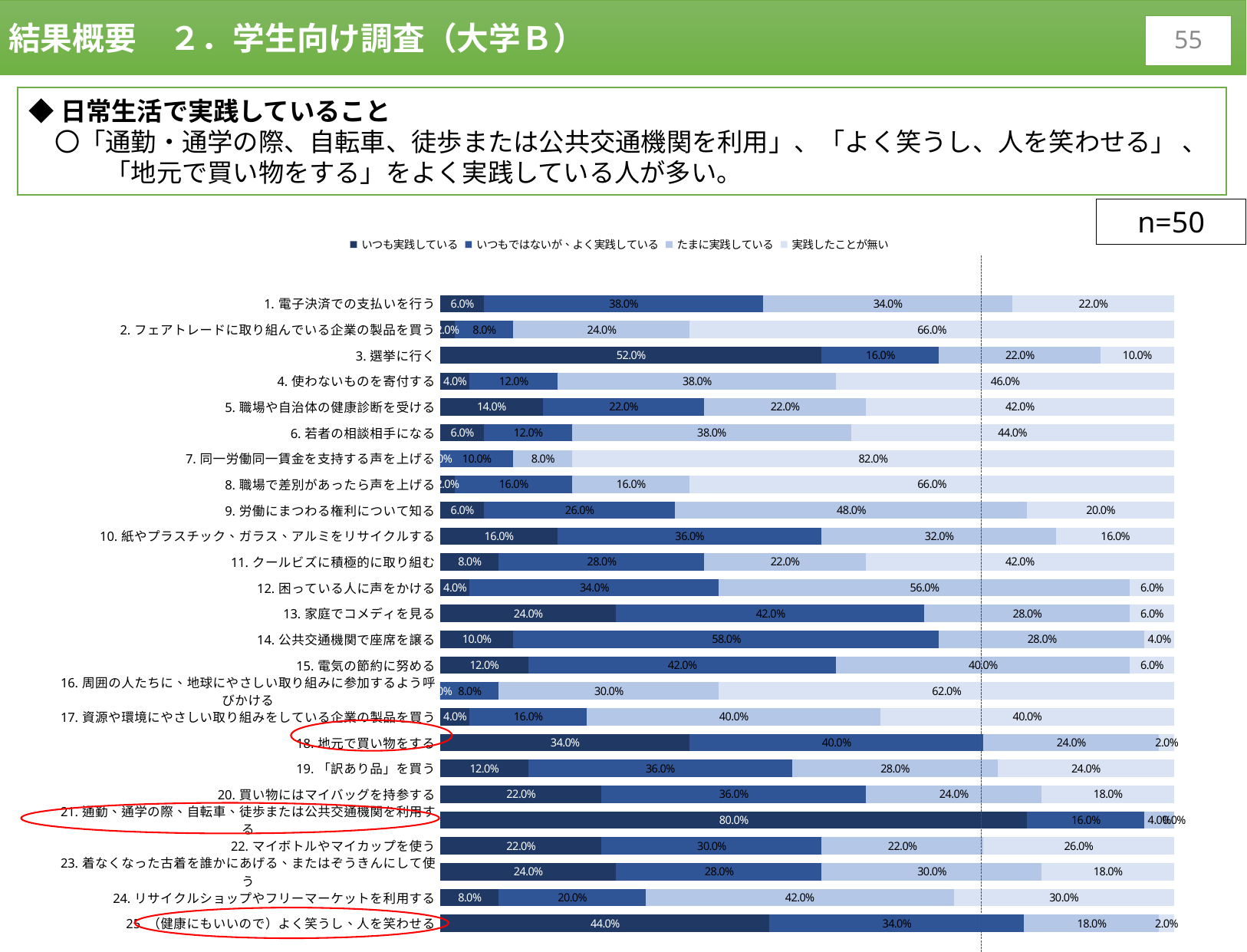
What is the value of いつも実践している for item 21 (通勤、通学の際、自転車、徒歩または公共交通機関を利用する)? 80.0% Which item has the highest value for いつも実践している? 21. 通勤、通学の際、自転車、徒歩または公共交通機関を利用する How many categories (items) are plotted in the chart? 25 Which item has the highest value for 実践したことが無い? 7. 同一労働同一賃金を支持する声を上げる Which is larger: the いつも実践している value for item 18 (地元で買い物をする) or for item 20 (買い物にはマイバッグを持参する)? 18. 地元で買い物をする What is the value of 実践したことが無い for item 7 (同一労働同一賃金を支持する声を上げる)? 82.0% What is the difference between the いつも実践している values for item 3 (選挙に行く) and item 25 (よく笑うし、人を笑わせる)? 8.0% What kind of chart is shown on the slide? Stacked bar chart What is the value of いつもではないが、よく実践している for item 14 (公共交通機関で座席を譲る)? 58.0% What is the value of たまに実践している for item 12 (困っている人に声をかける)? 56.0% How many series does the legend list? 4 What sample size (n) is shown on the slide? n=50